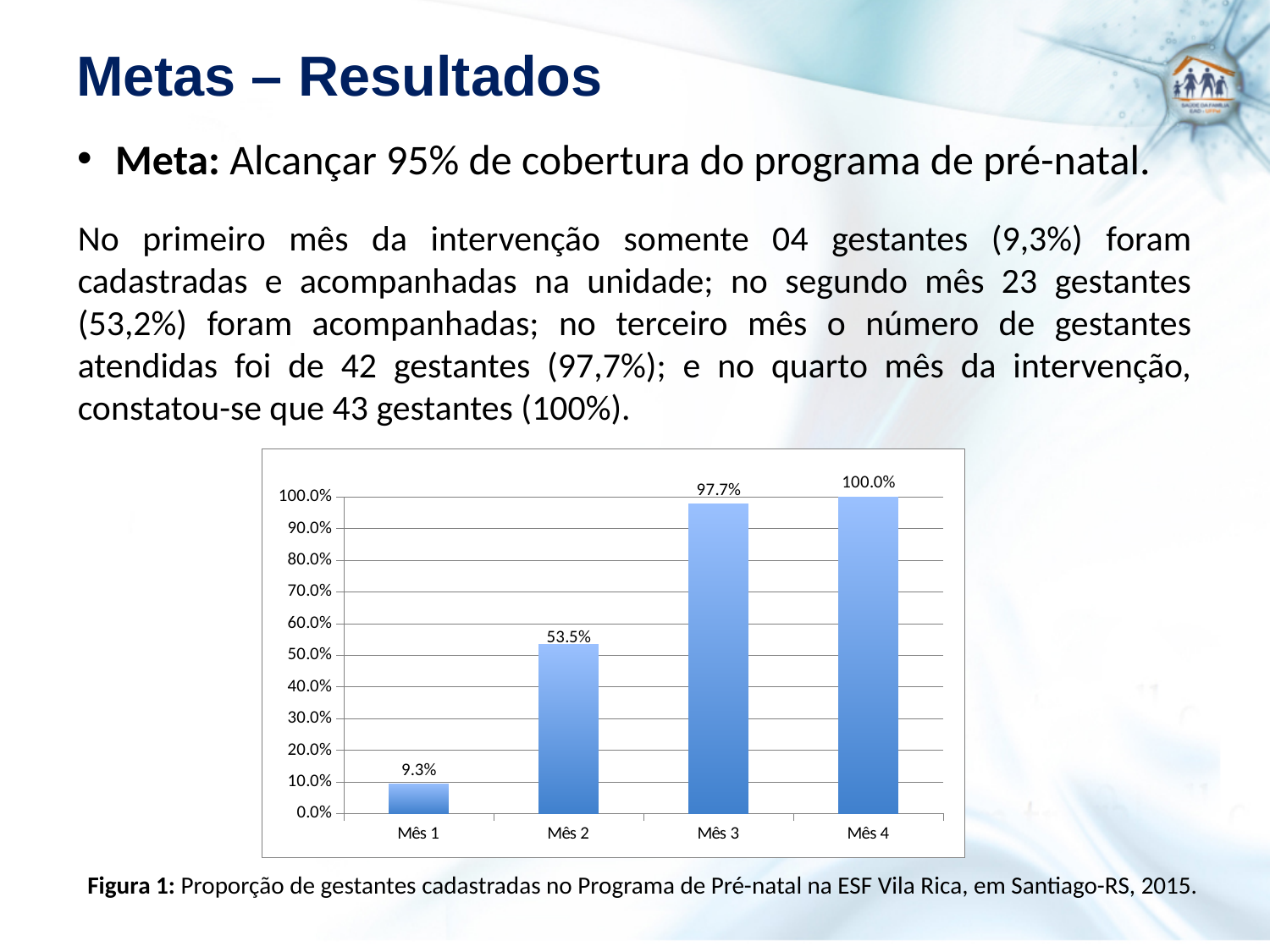
Which is larger, the value for Mês 2 or the value for Mês 3? Mês 3 Do the values rise or fall from Mês 1 to Mês 4? rise Which month has the highest value? Mês 4 How many months are shown on the x axis? 4 What kind of chart is shown on the slide? bar chart What is the difference between the values for Mês 3 and Mês 2? 44.2% What is the value for Mês 2? 53.5% What is the value for Mês 3? 97.7% What is the difference between the values for Mês 2 and Mês 1? 44.2% What is the value for Mês 1? 9.3% Which month has the lowest value? Mês 1 Is the value for Mês 2 greater or less than 50.0%? greater